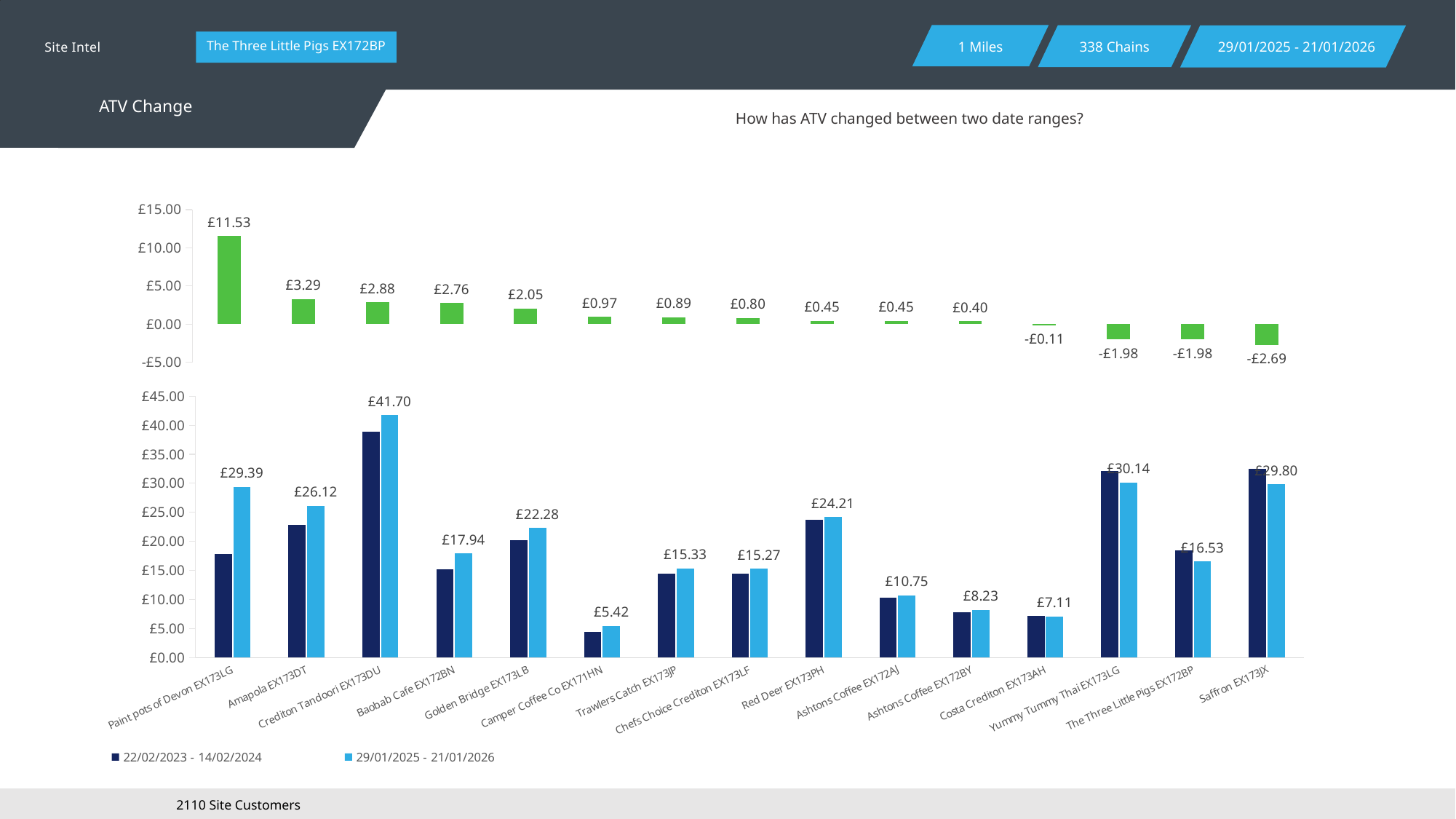
In the bottom chart, how many categories are shown on the x axis? 15 In the top chart (ATV change), which category has the lowest value? Saffron EX173JX In the top chart (ATV change), which category has the highest value? Paint pots of Devon EX173LG In the top chart (ATV change), what is the value for Paint pots of Devon EX173LG? £11.53 In the bottom chart, what is the difference between the 29/01/2025 - 21/01/2026 values for Amapola EX173DT and Baobab Cafe EX172BN? £8.18 In the top chart (ATV change), what is the difference between the values for Amapola EX173DT and Crediton Tandoori EX173DU? £0.41 In the top chart (ATV change), what is the value for Costa Crediton EX173AH? -£0.11 In the bottom chart, which category has the highest value in the 29/01/2025 - 21/01/2026 series? Crediton Tandoori EX173DU In the bottom chart, is the 22/02/2023 - 14/02/2024 value for Crediton Tandoori EX173DU greater or less than £35.00? greater In the bottom chart, what is the value for Crediton Tandoori EX173DU in the 29/01/2025 - 21/01/2026 series? £41.70 In the bottom chart, how many series does the legend list? 2 In the bottom chart, which category has the lowest value in the 29/01/2025 - 21/01/2026 series? Camper Coffee Co EX171HN